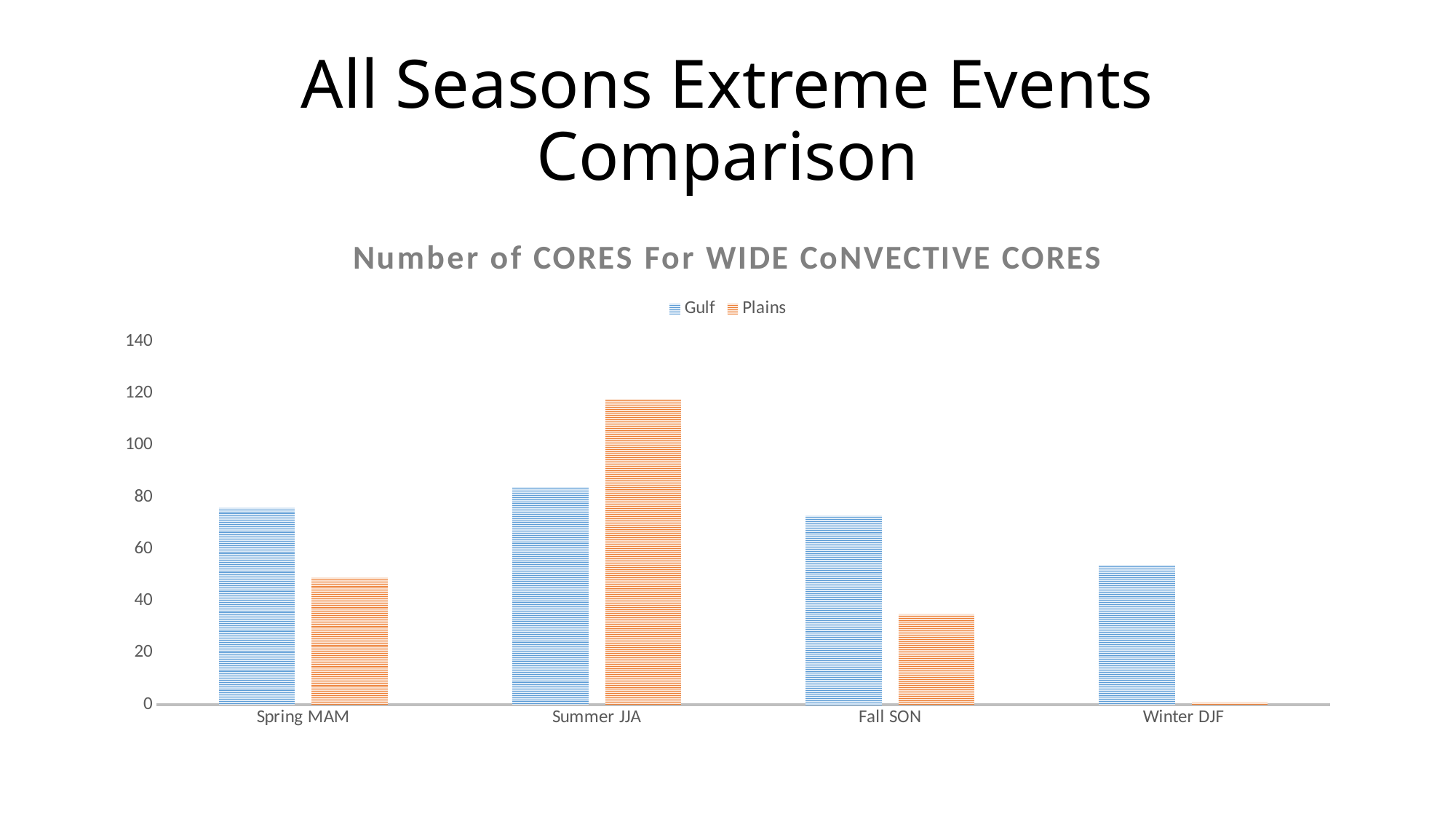
Is the Plains value for Fall SON greater or less than 40? less Which season has the lowest Plains value? Winter DJF Is the Gulf value for Winter DJF greater or less than 60? less Which season has the lowest Gulf value? Winter DJF How many seasons (categories) are shown on the x axis? 4 Is the Plains value for Summer JJA greater or less than 100? greater What is the title of the chart? Number of CORES For WIDE CoNVECTIVE CORES In Fall SON, which series has the larger value, Gulf or Plains? Gulf How many series does the legend list? 2 What kind of chart is shown on the slide? bar chart Which season has the highest Plains value? Summer JJA In Summer JJA, which series has the larger value, Gulf or Plains? Plains